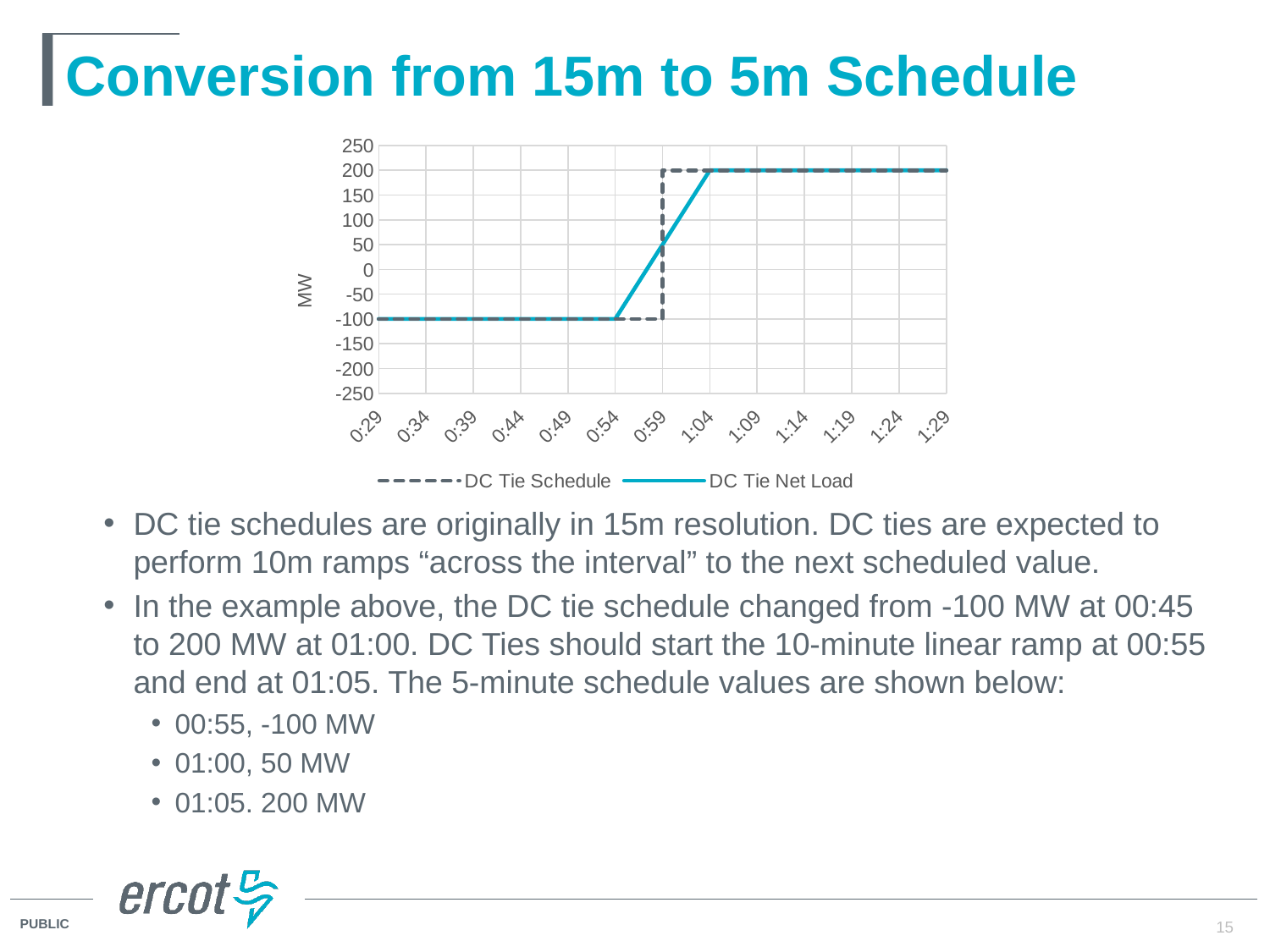
Does the DC Tie Net Load series rise or fall as time moves from 0:29 to 1:29? rise Is the value of DC Tie Net Load at 1:09 greater or less than 150? greater What is the lowest value reached by the DC Tie Schedule series? -100 What is the difference between the final value of DC Tie Schedule (200) and its initial value (-100)? 300 What is the value of DC Tie Schedule at 1:19? 200 How many series does the chart's legend list? 2 What is the label on the chart's vertical axis? MW What are the two series named in the chart's legend? DC Tie Schedule and DC Tie Net Load What is the highest value reached by the DC Tie Net Load series? 200 What kind of chart is shown on the slide? line chart What is the value of DC Tie Net Load at 1:29? 200 What is the value of DC Tie Net Load at 0:29? -100